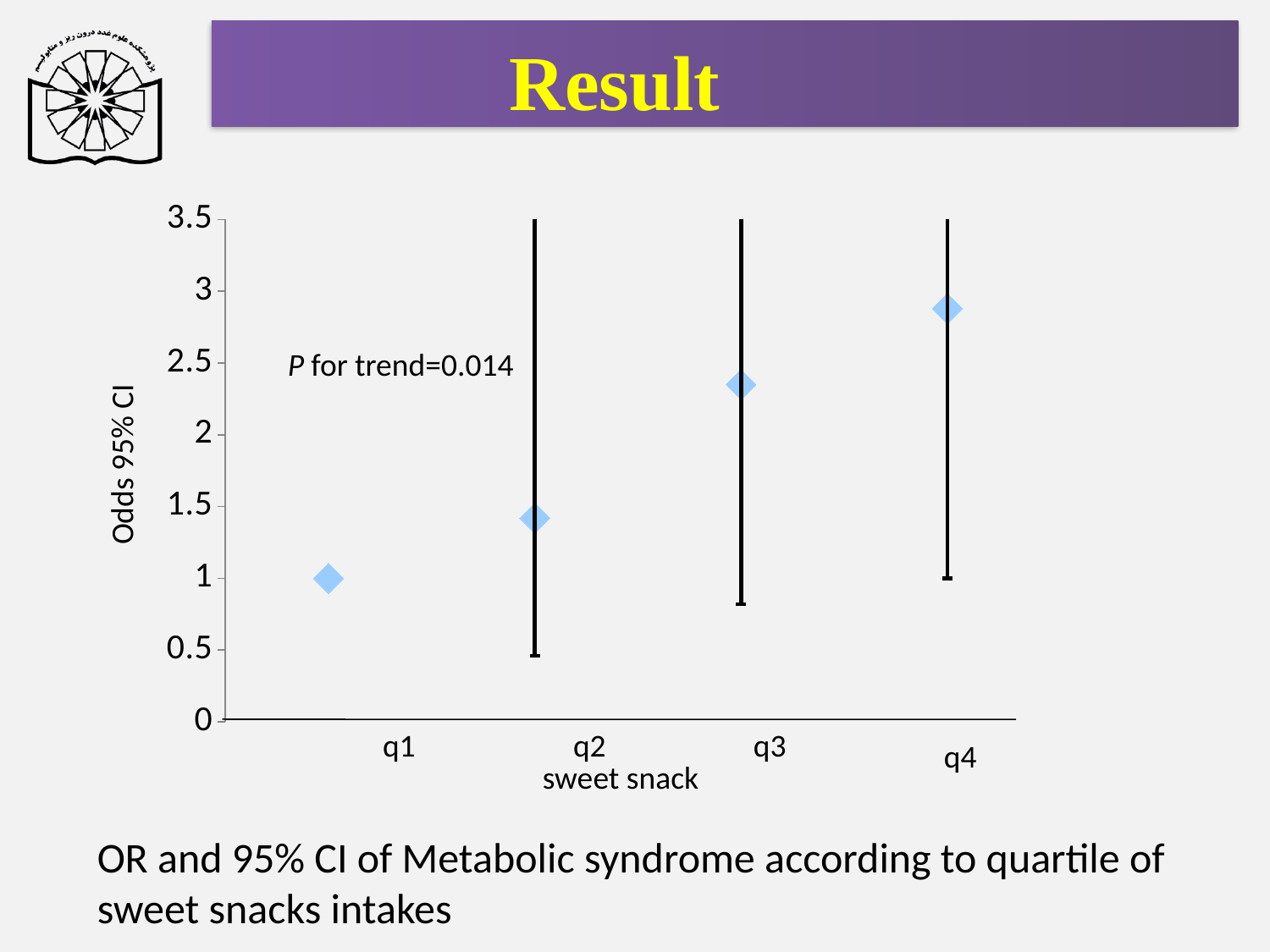
What kind of chart is shown on the slide? scatter chart Which quartile has the highest plotted odds ratio? q4 Is the plotted value for q3 greater or less than 2? greater What is the label of the y axis? Odds 95% CI Which has a larger plotted odds ratio, q2 or q3? q3 What P for trend value is printed on the chart? 0.014 Is the plotted value for q4 greater or less than 3? less What is the odds ratio value plotted for q1? 1 Do the plotted odds ratios rise or fall from q1 to q4? rise How many quartile categories are plotted along the x axis? 4 Is the plotted value for q2 greater or less than 1? greater Which quartile has the lowest plotted odds ratio? q1